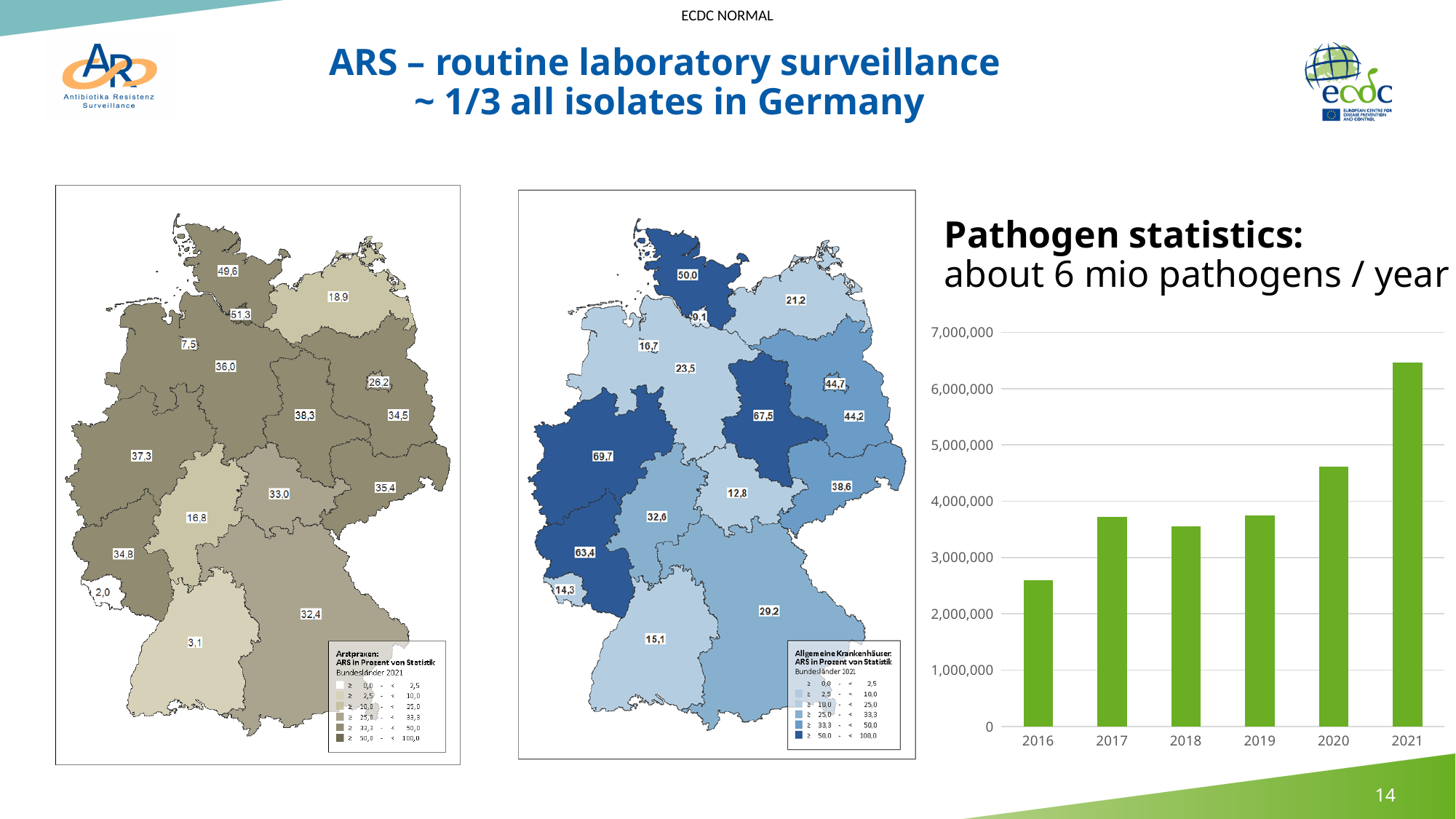
What colour are the bars in the 'Pathogen statistics' bar chart? green What kind of chart is the 'Pathogen statistics' chart on the right of the slide? bar chart What is the highest value printed on the left-hand map (Arztpraxen)? 51,3 What is the lowest value printed on the middle map (Allgemeine Krankenhäuser)? 9,1 In the 'Pathogen statistics' bar chart, do the values rise or fall from 2019 to 2021? rise In the 'Pathogen statistics' bar chart, which year has the lowest value? 2016 In the 'Pathogen statistics' bar chart, is the value for 2016 greater or less than 3,000,000? less In the 'Pathogen statistics' bar chart, is the value for 2021 greater or less than 6,000,000? greater In the 'Pathogen statistics' bar chart, is the value for 2020 greater or less than 4,000,000? greater How many years are shown on the x axis of the 'Pathogen statistics' bar chart? 6 In the 'Pathogen statistics' bar chart, which year has the highest value? 2021 In the 'Pathogen statistics' bar chart, which is larger, the value for 2020 or the value for 2017? 2020